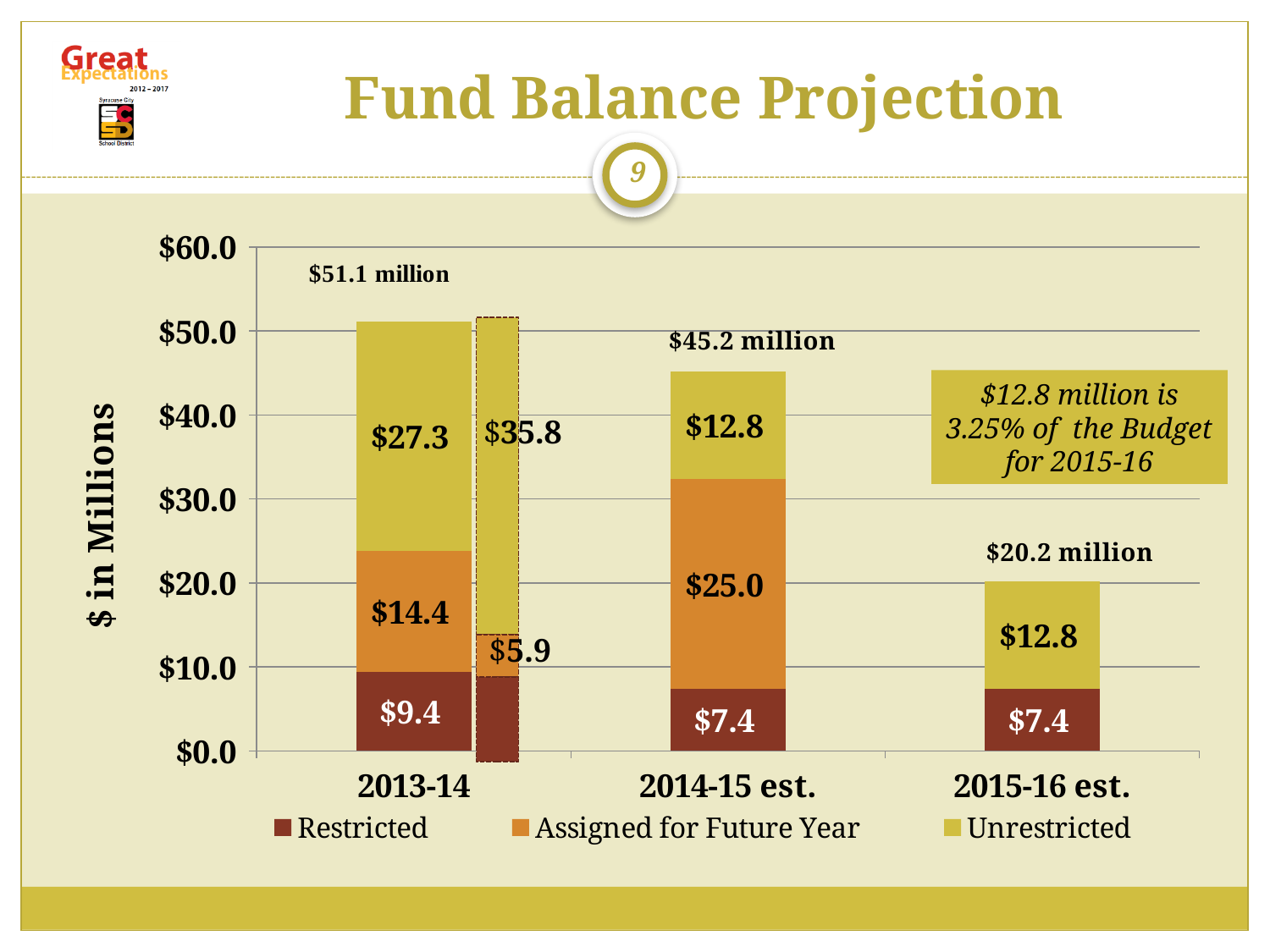
What is the Restricted value for 2015-16 est.? $7.4 Which year has the lowest total fund balance? 2015-16 est. What kind of chart is shown on the slide? Stacked bar chart What is the Unrestricted value for 2013-14? $27.3 What is the total fund balance shown for 2014-15 est.? $45.2 million How many series does the legend list? 3 Is the Unrestricted value larger for 2013-14 or for 2014-15 est.? 2013-14 What is the Assigned for Future Year value for 2014-15 est.? $25.0 Do the total fund balances rise or fall from 2013-14 to 2015-16 est.? Fall What is the total fund balance shown for 2015-16 est.? $20.2 million Which year has the highest total fund balance? 2013-14 What is the difference between the Restricted values for 2013-14 and 2014-15 est.? $2.0